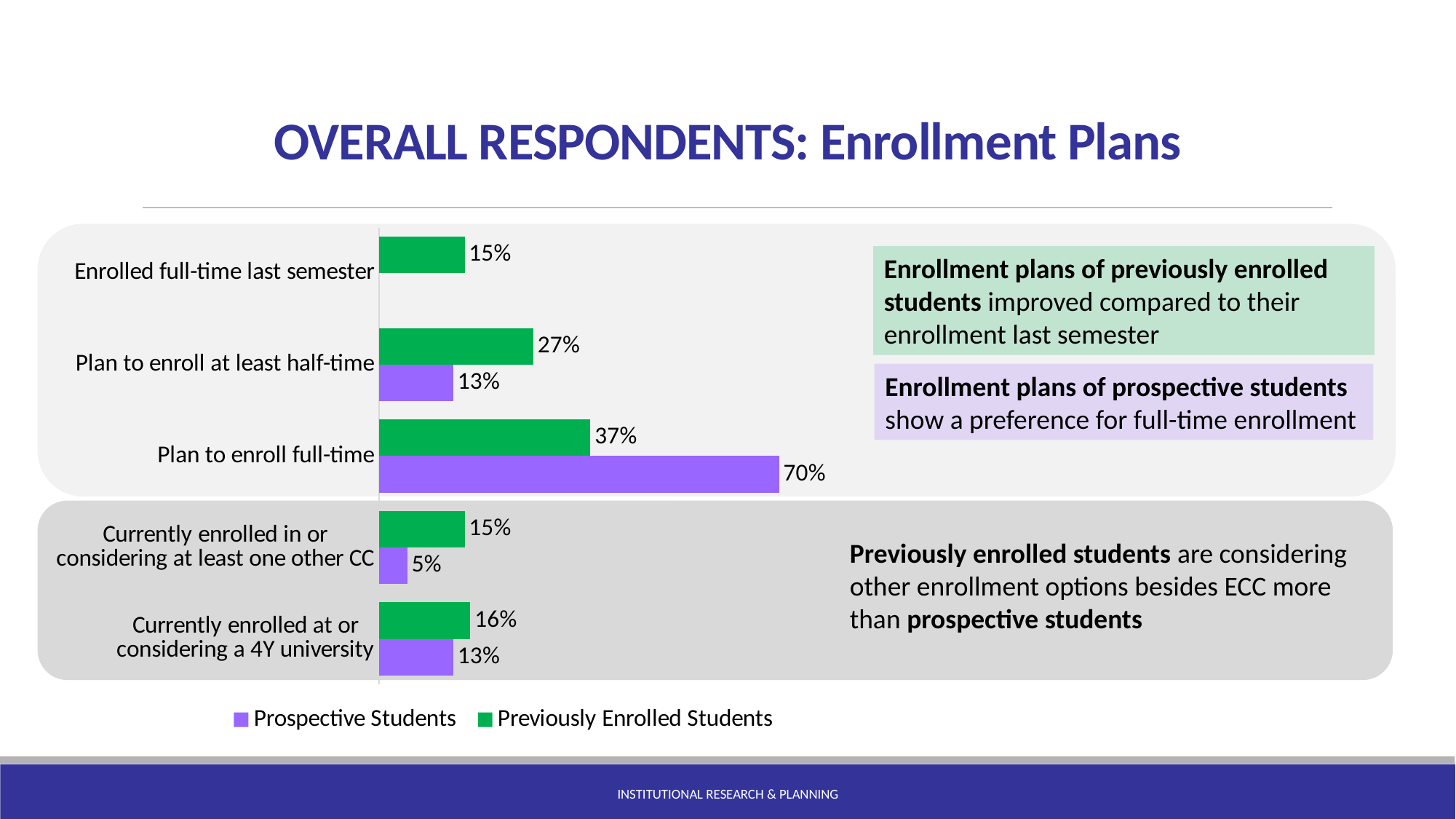
Which category has the lowest value for Prospective Students? Currently enrolled in or considering at least one other CC How many categories are shown on the chart? 5 Which colour represents Previously Enrolled Students in the chart? Green How many series does the legend list? 2 For 'Plan to enroll at least half-time', which series has the larger value: Prospective Students or Previously Enrolled Students? Previously Enrolled Students What percentage of Prospective Students are currently enrolled in or considering at least one other CC? 5% What kind of chart is shown on the slide? Bar chart What is the difference between Prospective Students and Previously Enrolled Students for 'Plan to enroll full-time'? 33% What percentage of Prospective Students plan to enroll full-time? 70% What percentage of Previously Enrolled Students plan to enroll full-time? 37% Which category has the highest value for Prospective Students? Plan to enroll full-time What percentage of Previously Enrolled Students were enrolled full-time last semester? 15%